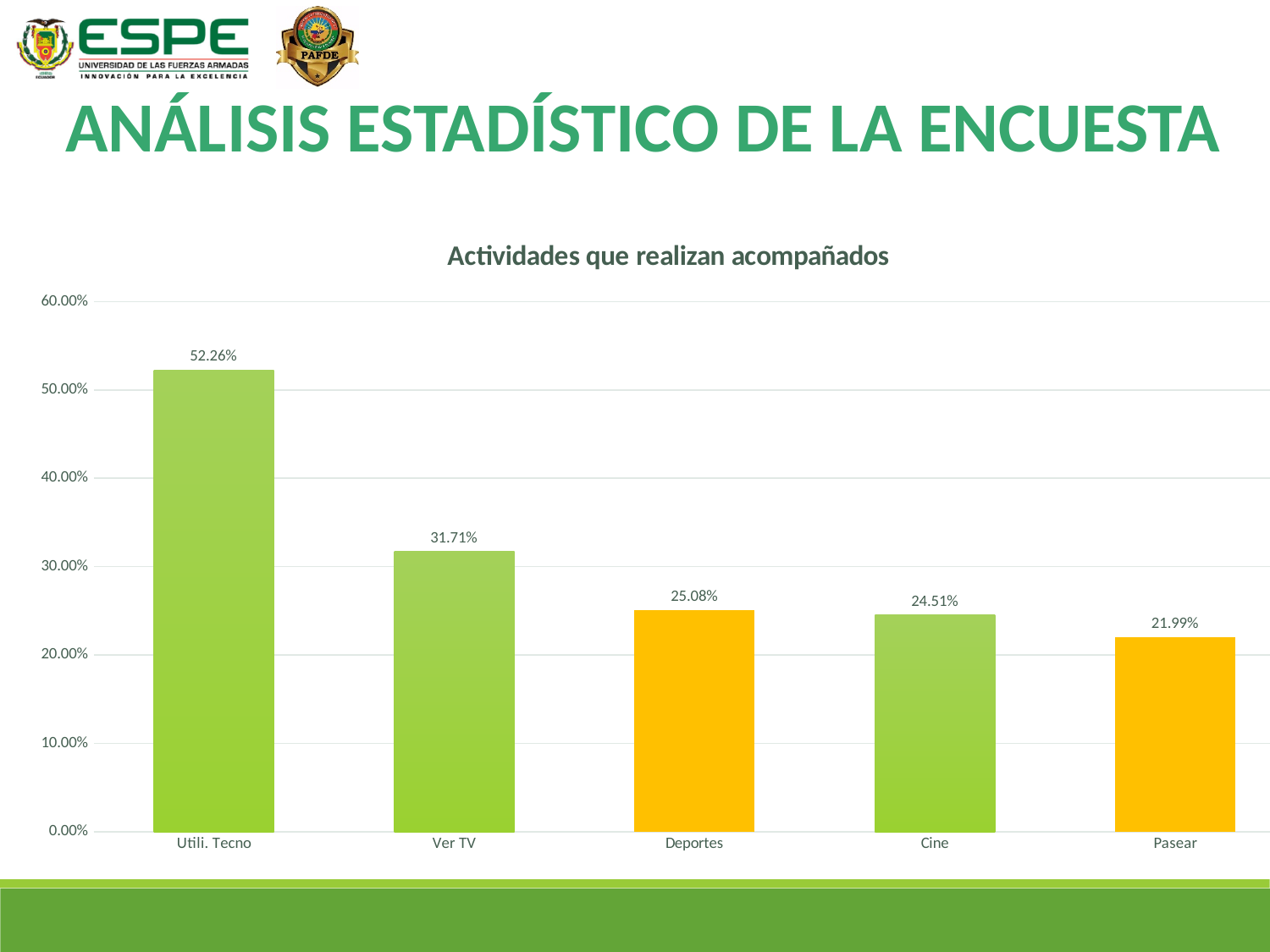
What is the value for Ver TV? 31.71% What is the difference between the values for Cine and Pasear? 2.52% What kind of chart is shown on the slide? Bar chart What is the title of the chart? Actividades que realizan acompañados Which category has the lowest value? Pasear What is the value for Deportes? 25.08% Which category has the highest value? Utili. Tecno Which is larger, the value for Ver TV or the value for Cine? Ver TV What is the difference between the values for Utili. Tecno and Ver TV? 20.55% How many categories are shown on the x axis? 5 What is the value for Utili. Tecno? 52.26% What is the value for Pasear? 21.99%